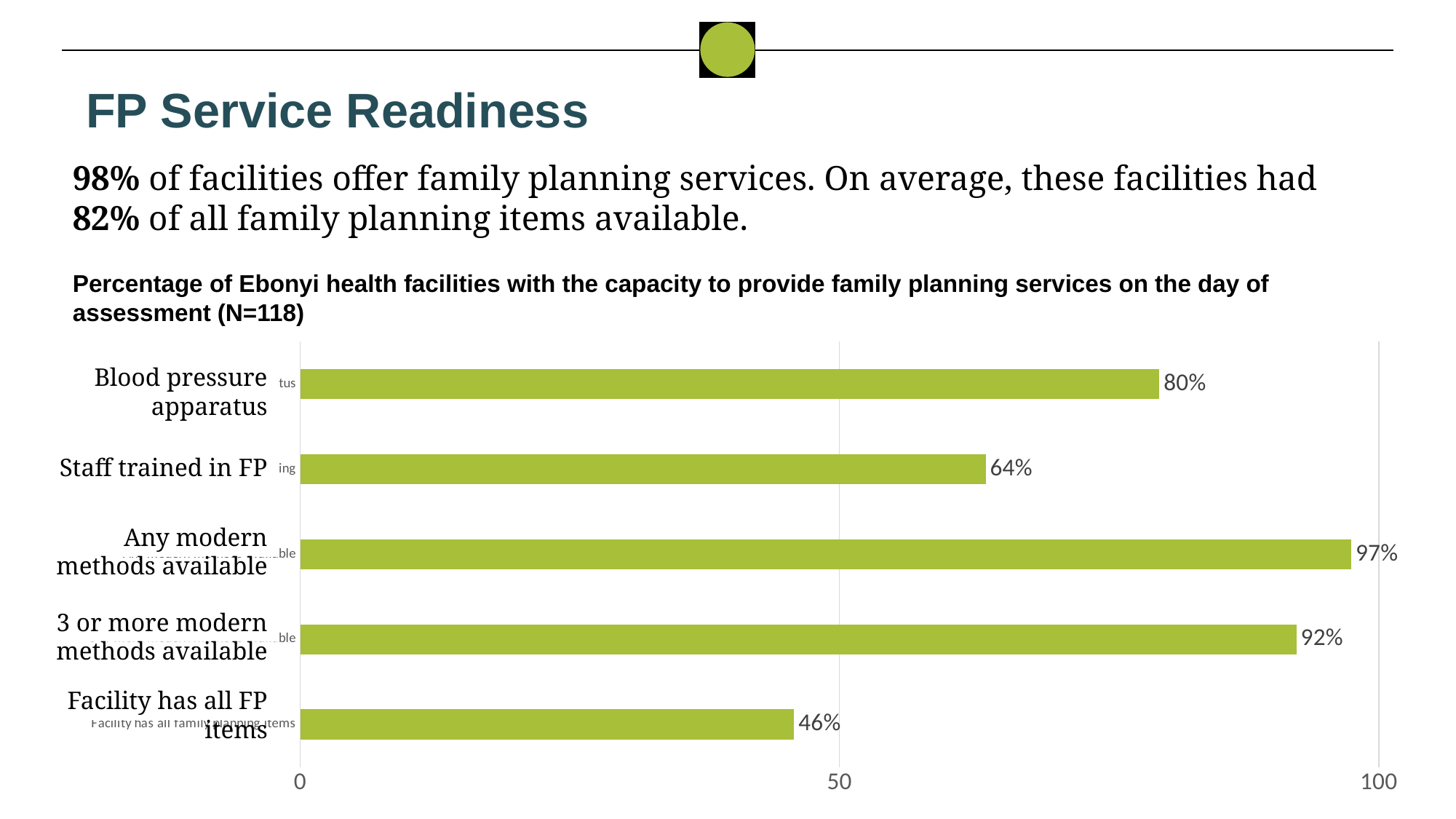
Which category has the highest percentage? Any modern methods available Which is larger: the percentage for blood pressure apparatus or for staff trained in FP? Blood pressure apparatus What percentage of facilities have a blood pressure apparatus? 80% What percentage of facilities have staff trained in FP? 64% What is the sample size (N) stated in the chart title? 118 What percentage of facilities have 3 or more modern methods available? 92% What kind of chart is shown on the slide? Bar chart What percentage of facilities have all FP items? 46% How many categories are shown in the chart? 5 What percentage of facilities have any modern methods available? 97% What is the difference between the percentage for any modern methods available and the percentage for facility has all FP items? 51% Which category has the lowest percentage? Facility has all FP items